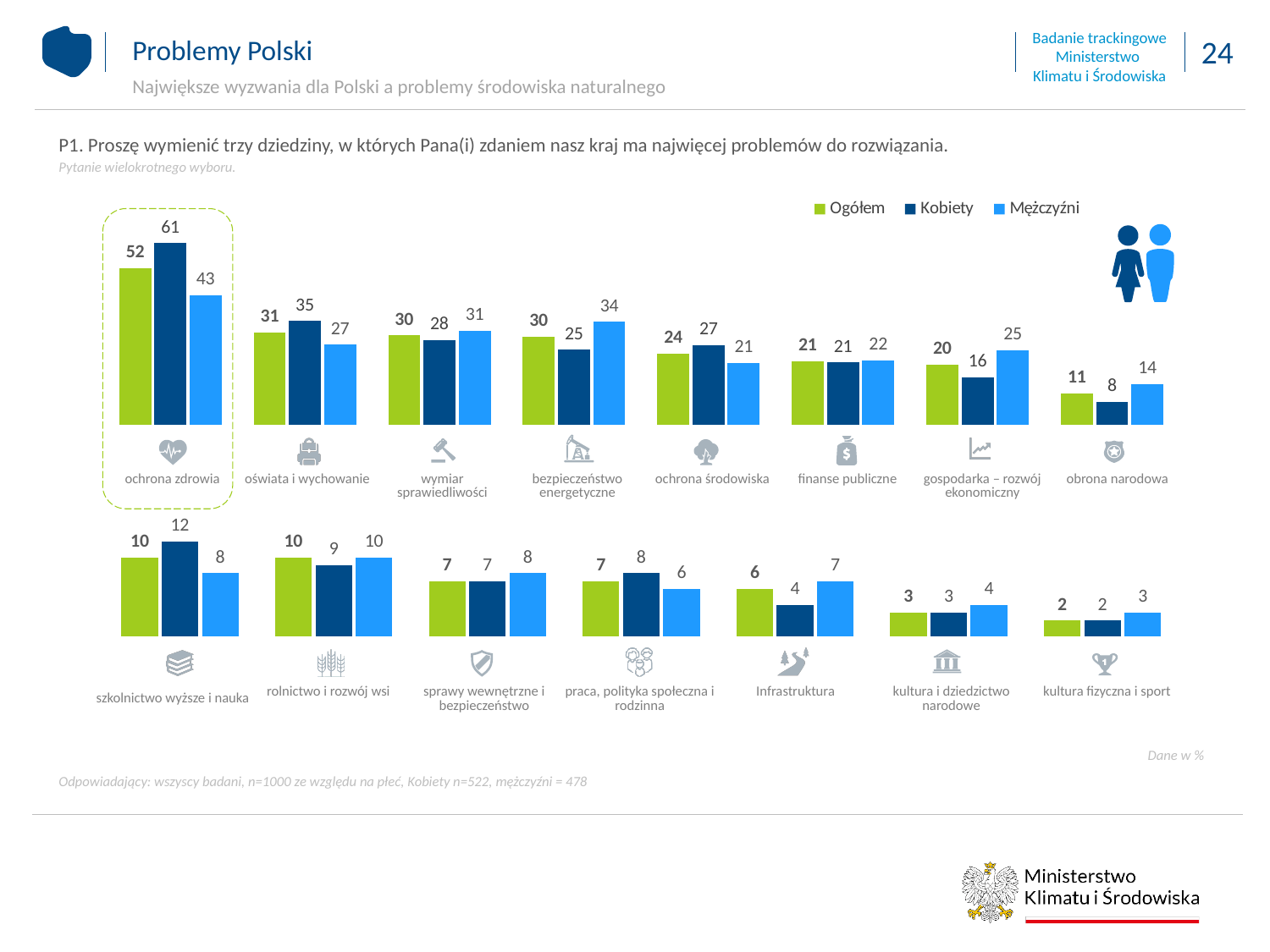
What is the difference between the Kobiety and Mężczyźni values for ochrona zdrowia? 18 Which is larger for ochrona środowiska: the Kobiety value or the Mężczyźni value? Kobiety Which category has the highest Ogółem value? ochrona zdrowia What is the Mężczyźni value for bezpieczeństwo energetyczne? 34 Which category has the lowest Ogółem value? kultura fizyczna i sport What kind of chart is shown on the slide? bar chart What is the Ogółem value for ochrona zdrowia? 52 How many categories are shown in the chart? 15 What is the Kobiety value for ochrona zdrowia? 61 What is the Kobiety value for gospodarka – rozwój ekonomiczny? 16 How many series does the legend list? 3 Which colour represents the Mężczyźni series in the legend? light blue